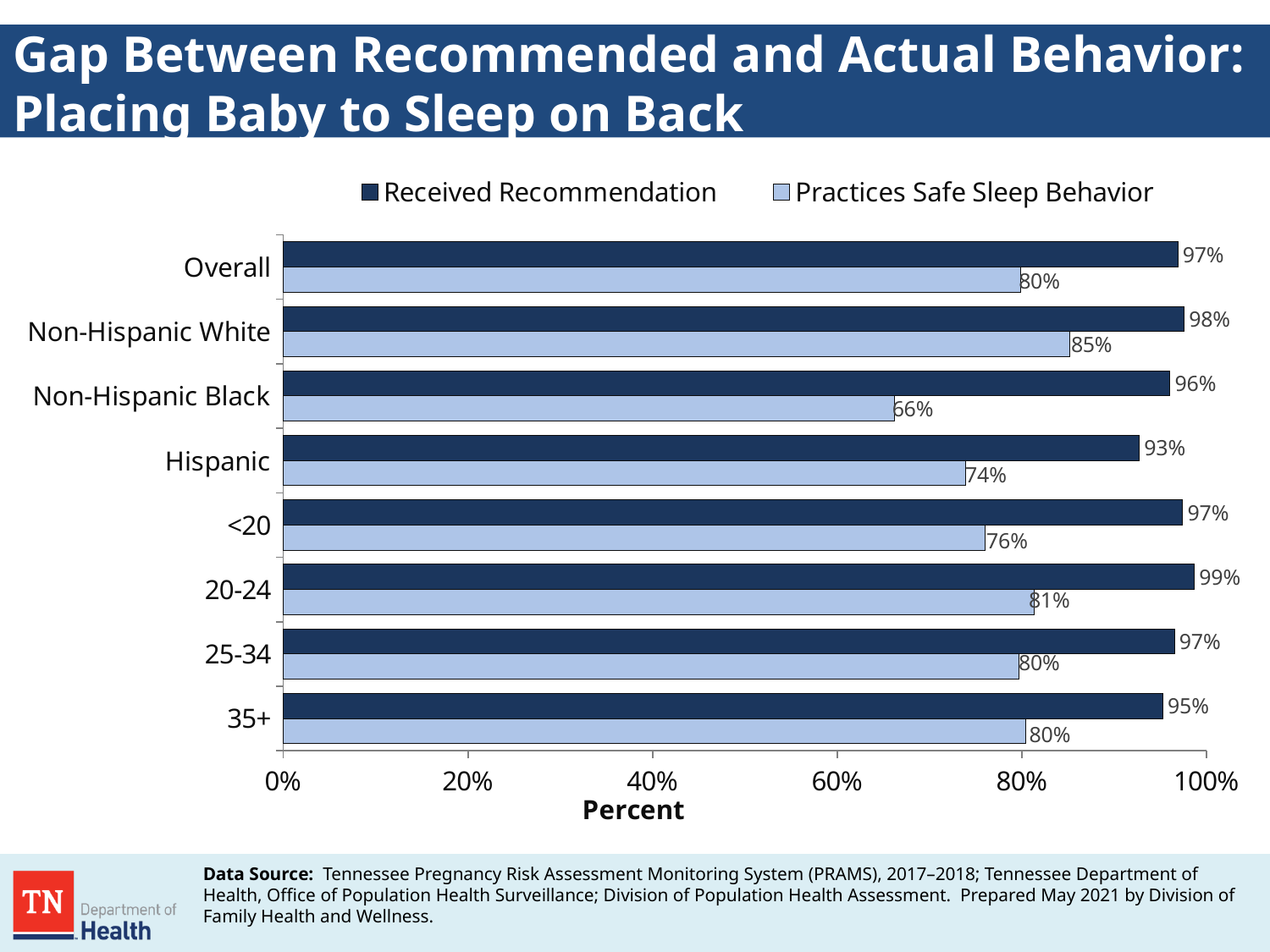
How many series does the legend list? 2 What percentage of the Overall group received the recommendation to place baby to sleep on back? 97% What percentage of Non-Hispanic Black respondents practice safe sleep behavior? 66% What is the label of the x axis? Percent How many categories are shown on the y axis of the chart? 8 What is the difference between Received Recommendation and Practices Safe Sleep Behavior for the Hispanic group? 19% Which is larger: the Practices Safe Sleep Behavior value for Non-Hispanic White or for Hispanic? Non-Hispanic White Which category has the lowest Practices Safe Sleep Behavior value? Non-Hispanic Black Which category has the highest Received Recommendation value? 20-24 What type of chart is shown on the slide? Bar chart What is the Practices Safe Sleep Behavior value for the 20-24 age group? 81% Which series is shown in the lighter blue colour? Practices Safe Sleep Behavior